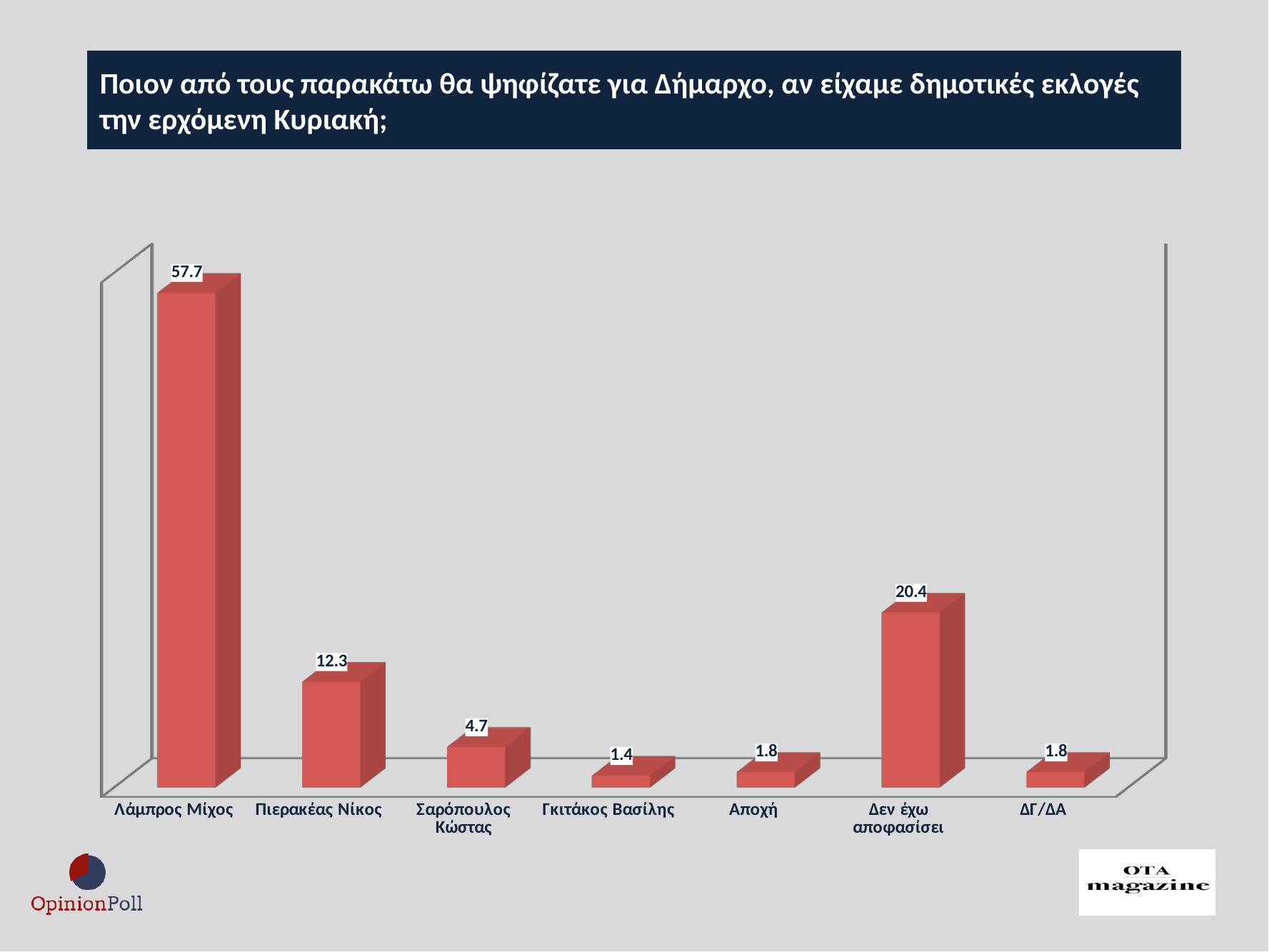
What is the difference between the values for Λάμπρος Μίχος and Πιερακέας Νίκος? 45.4 Which category has the lowest value? Γκιτάκος Βασίλης What value is shown for Πιερακέας Νίκος? 12.3 What is the difference between the values for Δεν έχω αποφασίσει and Πιερακέας Νίκος? 8.1 Which is larger, the value for Δεν έχω αποφασίσει or the value for Πιερακέας Νίκος? Δεν έχω αποφασίσει What value is shown for Δεν έχω αποφασίσει? 20.4 How many categories are shown on the x axis? 7 What kind of chart is shown on the slide? Bar chart What value is shown for Σαρόπουλος Κώστας? 4.7 What value is shown for Λάμπρος Μίχος? 57.7 What value is shown for Γκιτάκος Βασίλης? 1.4 Which category has the highest value? Λάμπρος Μίχος